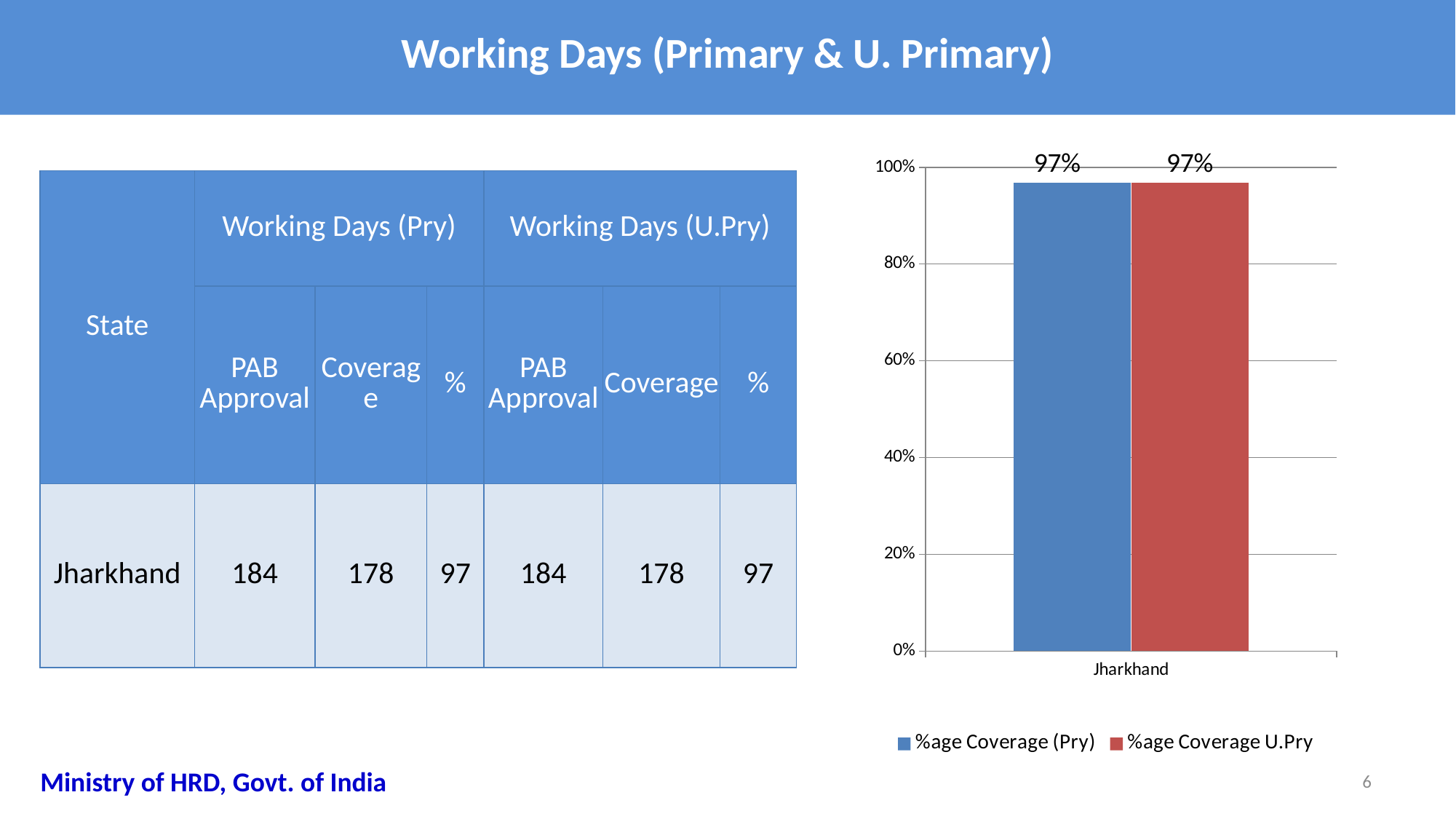
What is the value for %age Coverage (Pry) for Jharkhand in the chart? 97% What is the difference between the %age Coverage (Pry) and %age Coverage U.Pry values for Jharkhand in the chart? 0% What kind of chart is shown on the slide? Bar chart How many series does the chart legend list? 2 Is the value for %age Coverage U.Pry for Jharkhand greater or less than 100%? less Is the value for %age Coverage (Pry) for Jharkhand greater or less than 80%? greater What is the value for %age Coverage U.Pry for Jharkhand in the chart? 97% What is the highest value shown on the y axis of the chart? 100% Which state is shown on the x axis of the chart? Jharkhand What colour is the bar for %age Coverage U.Pry in the chart? Red How many categories are shown on the x axis of the chart? 1